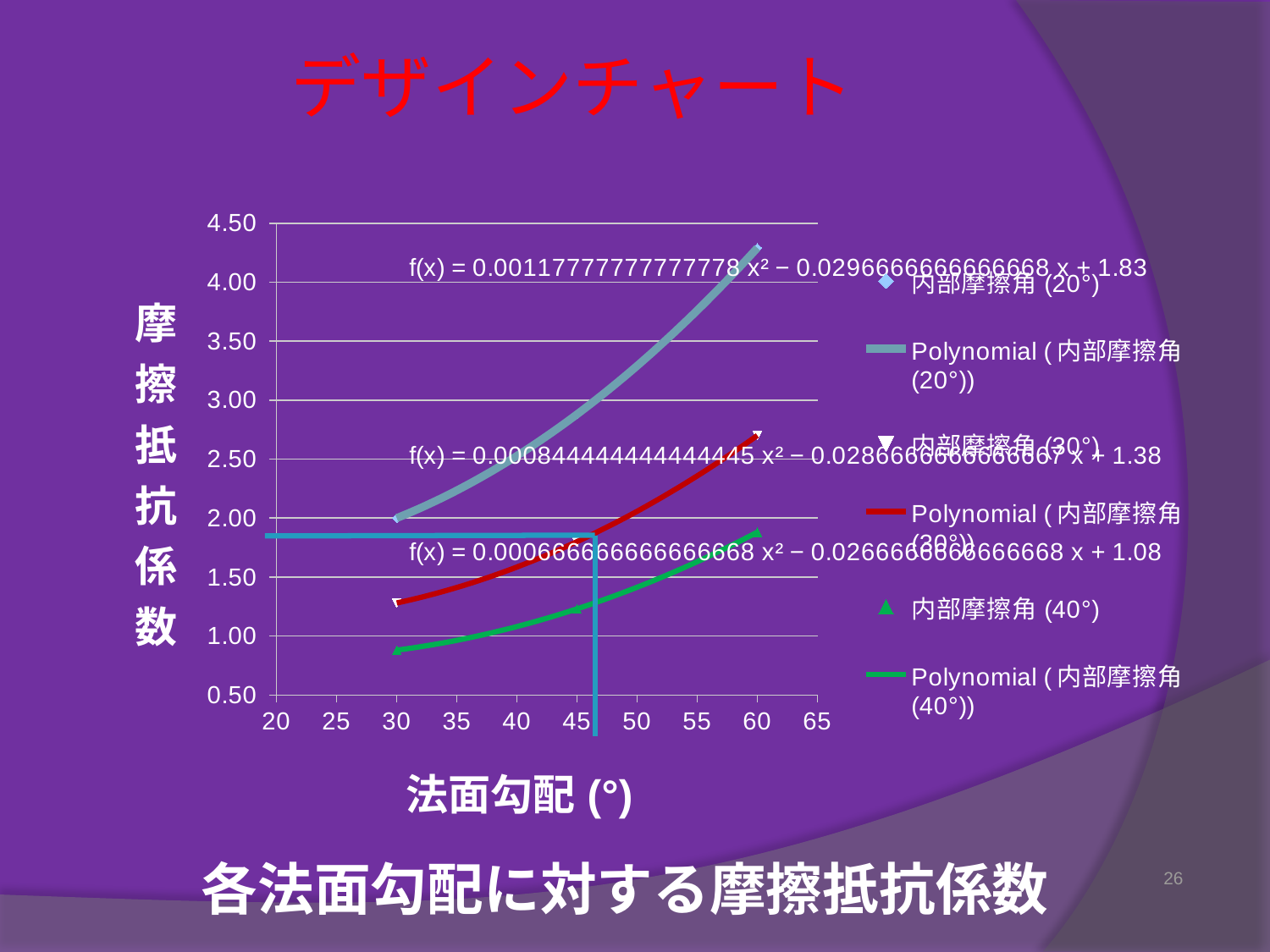
Is the value for 内部摩擦角 (30°) at 法面勾配 60 greater or less than 2.50? greater Do the values of the 内部摩擦角 (20°) series rise or fall as 法面勾配 increases? rise How many entries does the chart legend list? 6 Is the value for 内部摩擦角 (30°) at 法面勾配 30 greater or less than 1.50? less Is the value for 内部摩擦角 (40°) at 法面勾配 30 greater or less than 1.00? less What kind of chart is shown on the slide? scatter chart How many data points are plotted for the 内部摩擦角 (20°) series? 3 At 法面勾配 60, which series has the larger value, 内部摩擦角 (20°) or 内部摩擦角 (40°)? 内部摩擦角 (20°) What is the title of the x axis of the chart? 法面勾配 (°) Which series has the lowest values across the chart? 内部摩擦角 (40°) What is the constant term in the polynomial trendline equation for 内部摩擦角 (20°)? 1.83